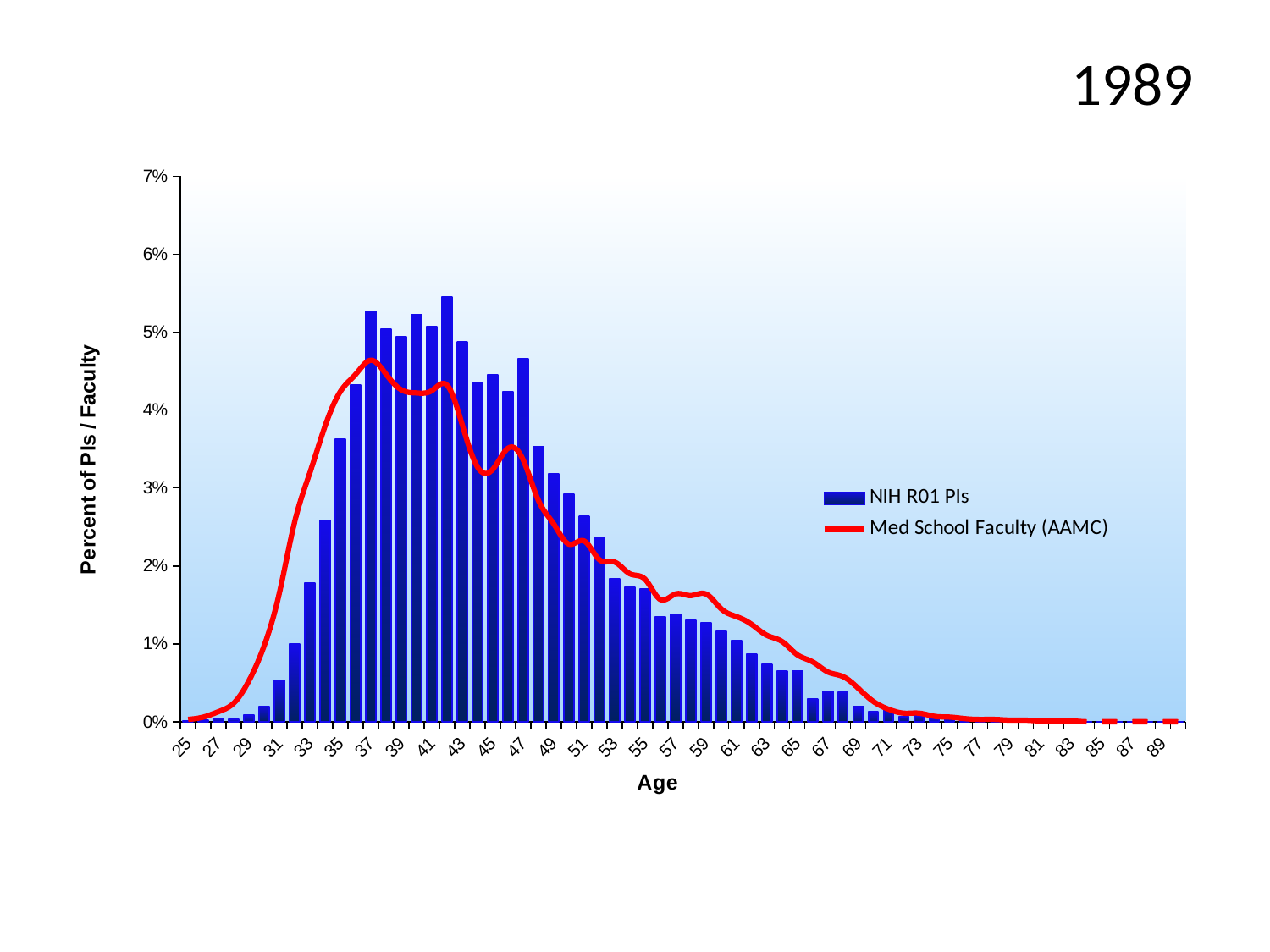
Is the NIH R01 PIs value at age 33 greater or less than 2%? less Is the Med School Faculty (AAMC) value at age 29 greater or less than 1%? less What are the two series named in the legend? NIH R01 PIs and Med School Faculty (AAMC) Is the NIH R01 PIs value at age 43 greater or less than 5%? less Which is larger for NIH R01 PIs: the value at age 35 or the value at age 55? Age 35 How many series does the legend list? 2 At age 31, which series has the higher value: NIH R01 PIs or Med School Faculty (AAMC)? Med School Faculty (AAMC) Do the NIH R01 PIs values generally rise or fall from age 49 to age 69? fall What is the label on the vertical axis? Percent of PIs / Faculty What kind of chart is this? A bar chart with a line series overlaid